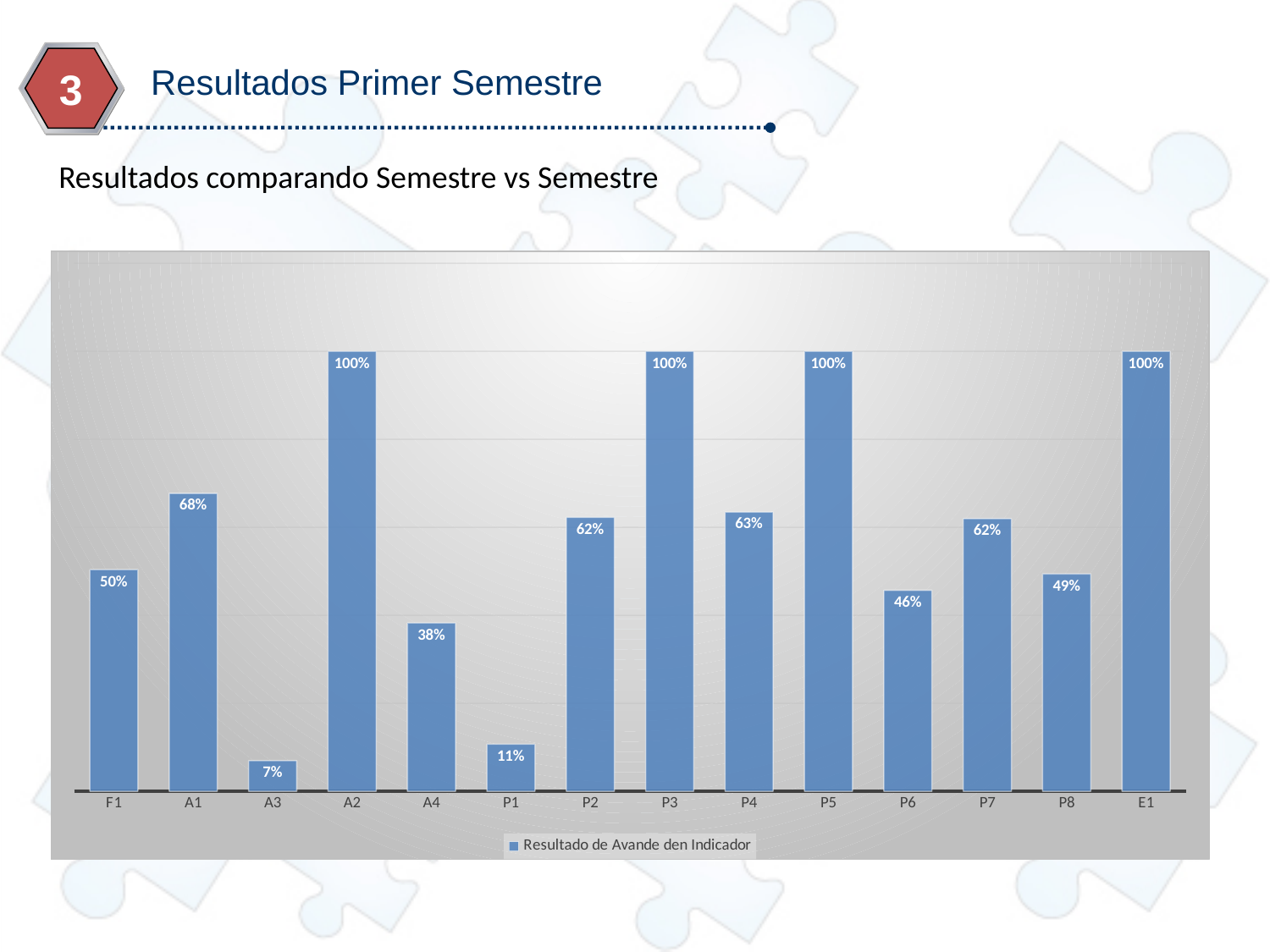
Which category has the lowest value? A3 What kind of chart is shown on the slide? Bar chart Which is larger, the value for P8 or the value for P6? P8 What is the difference between the values for P1 and A3? 4% How many series does the legend list? 1 What is the difference between the values for A1 and F1? 18% What is the value for A4? 38% How many categories are shown on the x axis? 14 What is the value for P4? 63% What is the value for P6? 46% What is the value for A1? 68% Which is larger, the value for A4 or the value for P2? P2